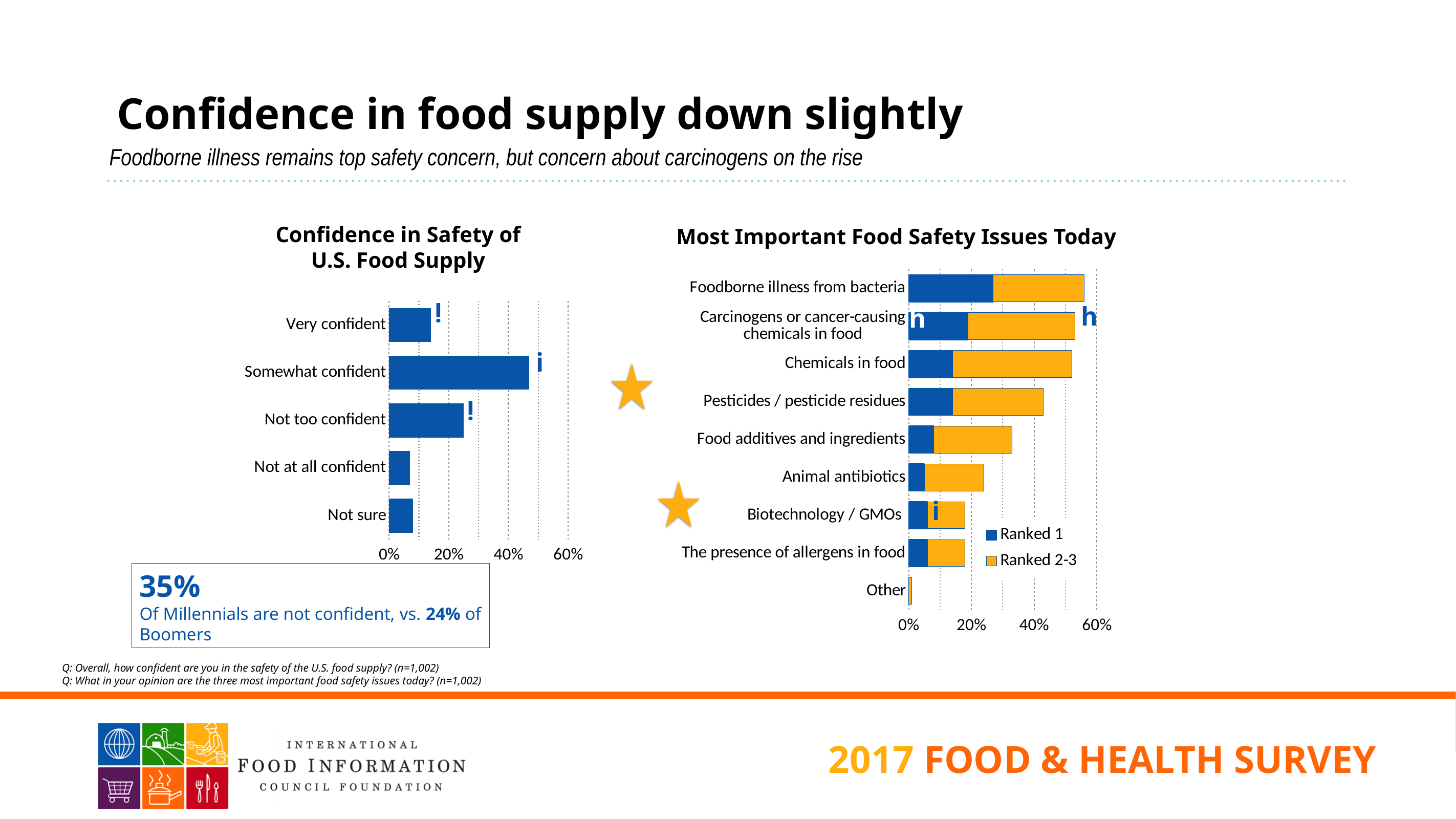
In the 'Most Important Food Safety Issues Today' chart, how many categories are shown? 9 In the 'Most Important Food Safety Issues Today' chart, how many series does the legend list? 2 In the 'Most Important Food Safety Issues Today' chart, is the total for Food additives and ingredients greater or less than 20%? greater In the 'Confidence in Safety of U.S. Food Supply' chart, is the value for Very confident greater or less than 20%? less In the 'Confidence in Safety of U.S. Food Supply' chart, which is larger: Not too confident or Very confident? Not too confident In the 'Most Important Food Safety Issues Today' chart, which legend entry is shown in blue? Ranked 1 In the 'Confidence in Safety of U.S. Food Supply' chart, which category has the highest value? Somewhat confident In the 'Confidence in Safety of U.S. Food Supply' chart, is the value for Somewhat confident greater or less than 40%? greater In the 'Most Important Food Safety Issues Today' chart, which category has the lowest total? Other What kind of chart is the 'Confidence in Safety of U.S. Food Supply' chart? bar chart In the 'Most Important Food Safety Issues Today' chart, which issue has the highest total? Foodborne illness from bacteria In the 'Confidence in Safety of U.S. Food Supply' chart, how many categories are shown? 5